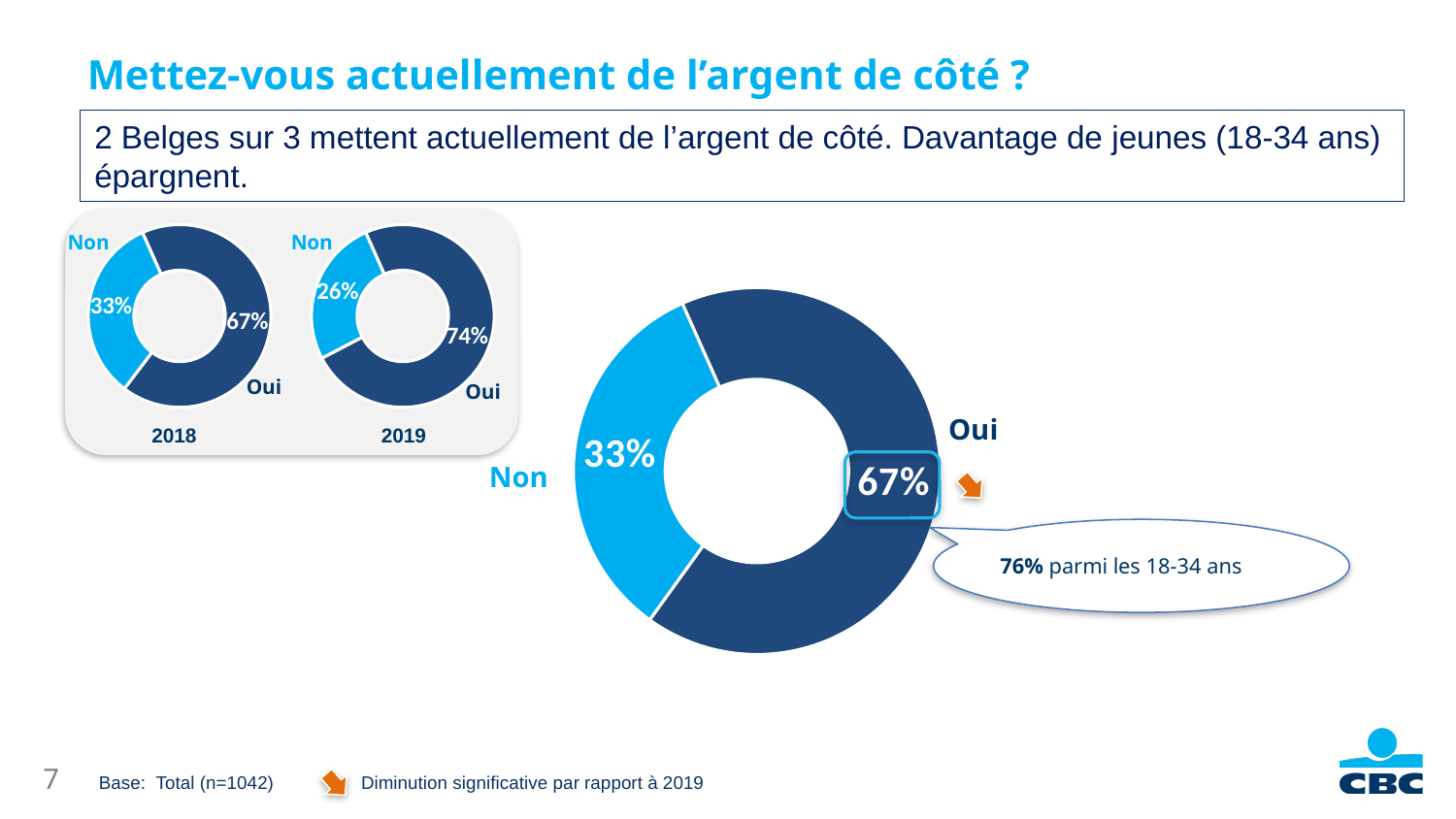
In the small 2019 donut chart, what percentage answered "Non"? 26% According to the callout next to the large donut chart, what percentage of 18-34 year olds answered "Oui"? 76% In the small 2019 donut chart, which answer has the smaller share? Non In the small 2019 donut chart, what percentage answered "Oui"? 74% What is the difference in percentage points between the "Oui" share in the 2019 donut chart and the "Oui" share in the 2018 donut chart? 7 In the large donut chart, what percentage answered "Oui"? 67% What is the difference in percentage points between "Oui" and "Non" in the large donut chart? 34 In the small 2018 donut chart, what percentage answered "Oui"? 67% How many slices does the large donut chart have? 2 In the large donut chart, what percentage answered "Non"? 33% What kind of chart is the large chart on the slide? Donut (pie) chart In the large donut chart, which answer has the larger share, "Oui" or "Non"? Oui